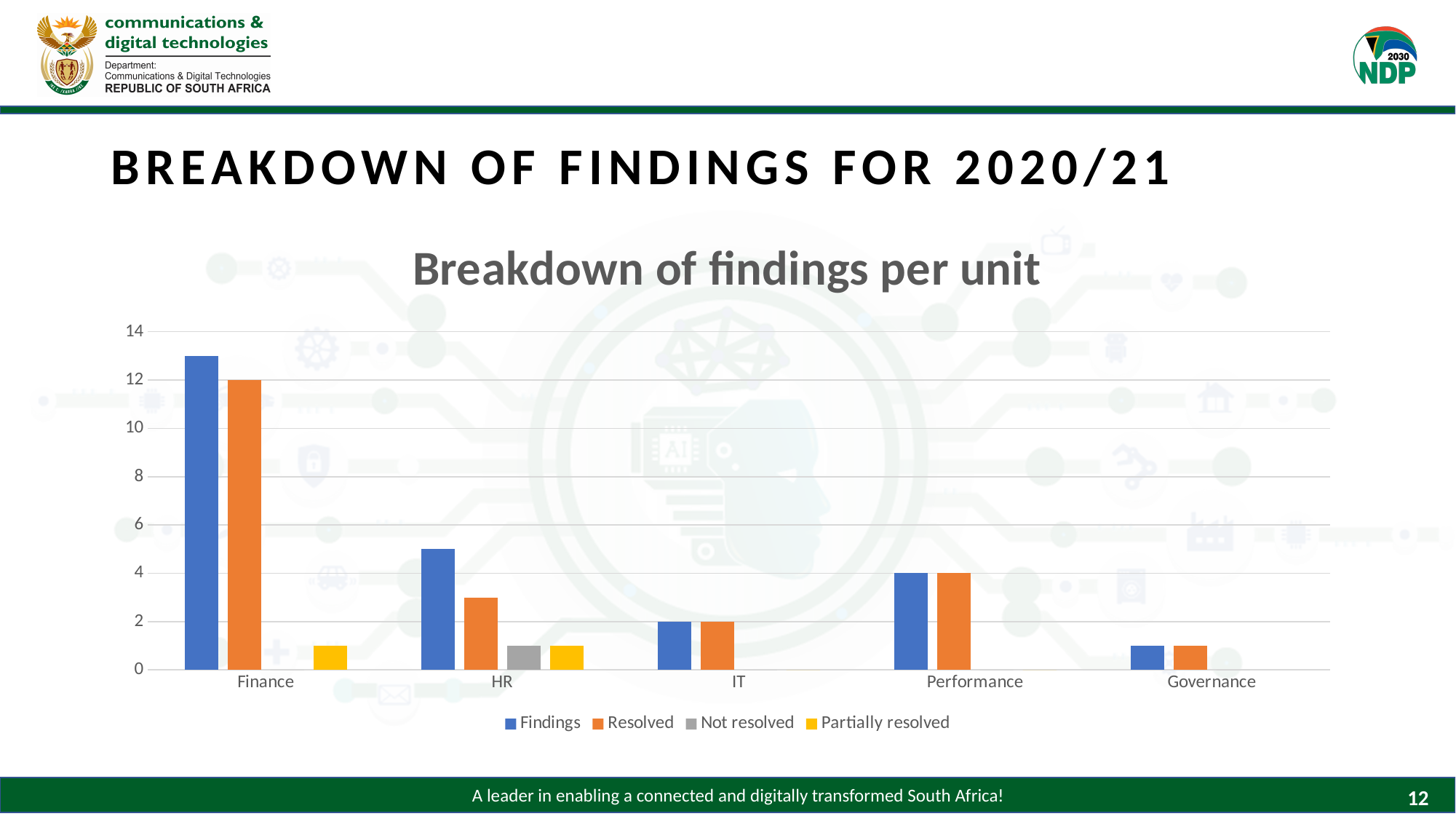
What type of chart is shown on the slide? bar chart Which unit has the highest number of Findings? Finance What is the Findings value for IT? 2 What is the Resolved value for Finance? 12 What is the title of the chart? Breakdown of findings per unit How many units (categories) are shown on the x axis? 5 Which is larger for HR: Findings or Resolved? Findings Which unit has the lowest number of Findings? Governance How many series does the legend list? 4 What is the Findings value for Performance? 4 What is the difference between the Findings value for Performance and the Findings value for IT? 2 Is the Findings value for HR greater or less than 4? greater